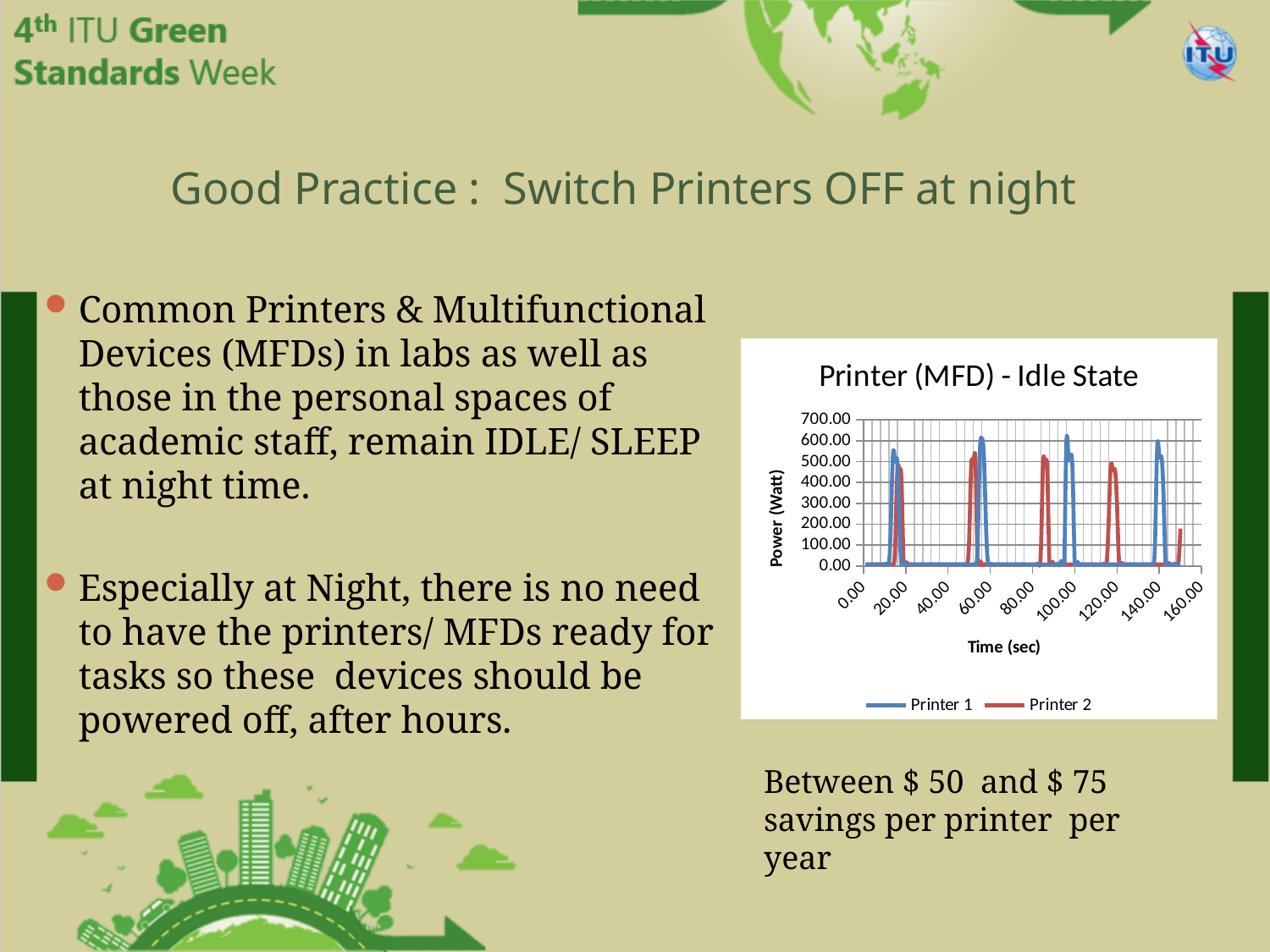
What is the title of the chart? Printer (MFD) - Idle State What is the highest value shown on the vertical axis of the chart? 700.00 What is the label of the horizontal axis of the chart? Time (sec) Is the power of Printer 1 between its spikes greater or less than 100 watts? less Which series reaches the higher peak power, Printer 1 or Printer 2? Printer 1 Is the highest peak of Printer 2 greater or less than 600 watts? less What kind of chart is shown on the slide? line chart How many series does the chart's legend list? 2 What is the highest value shown on the horizontal axis of the chart? 160.00 Is the highest peak of Printer 1 greater or less than 500 watts? greater What are the names of the two series in the chart's legend? Printer 1 and Printer 2 What is the label of the vertical axis of the chart? Power (Watt)